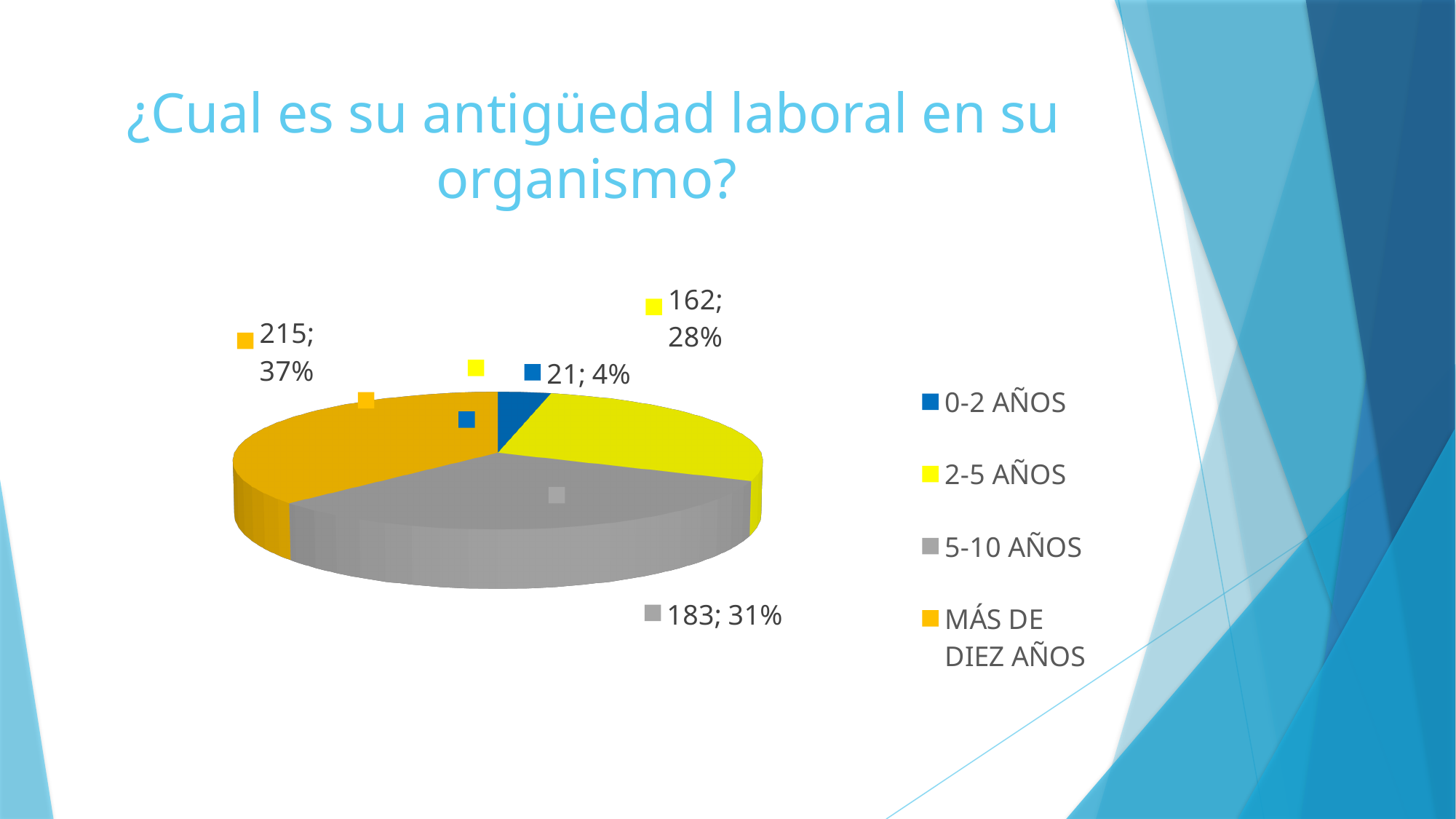
Which is larger, the value for 5-10 AÑOS or the value for 2-5 AÑOS? 5-10 AÑOS What is the value for 5-10 AÑOS? 183 What is the value for MÁS DE DIEZ AÑOS? 215 Which category has the lowest value? 0-2 AÑOS What kind of chart is shown on the slide? pie chart What is the value for 0-2 AÑOS? 21 What share of the pie does MÁS DE DIEZ AÑOS represent? 37% Which category has the highest value? MÁS DE DIEZ AÑOS How many categories does the pie chart show? 4 What is the difference between the values for MÁS DE DIEZ AÑOS and 5-10 AÑOS? 32 What is the value for 2-5 AÑOS? 162 What share of the pie does 2-5 AÑOS represent? 28%